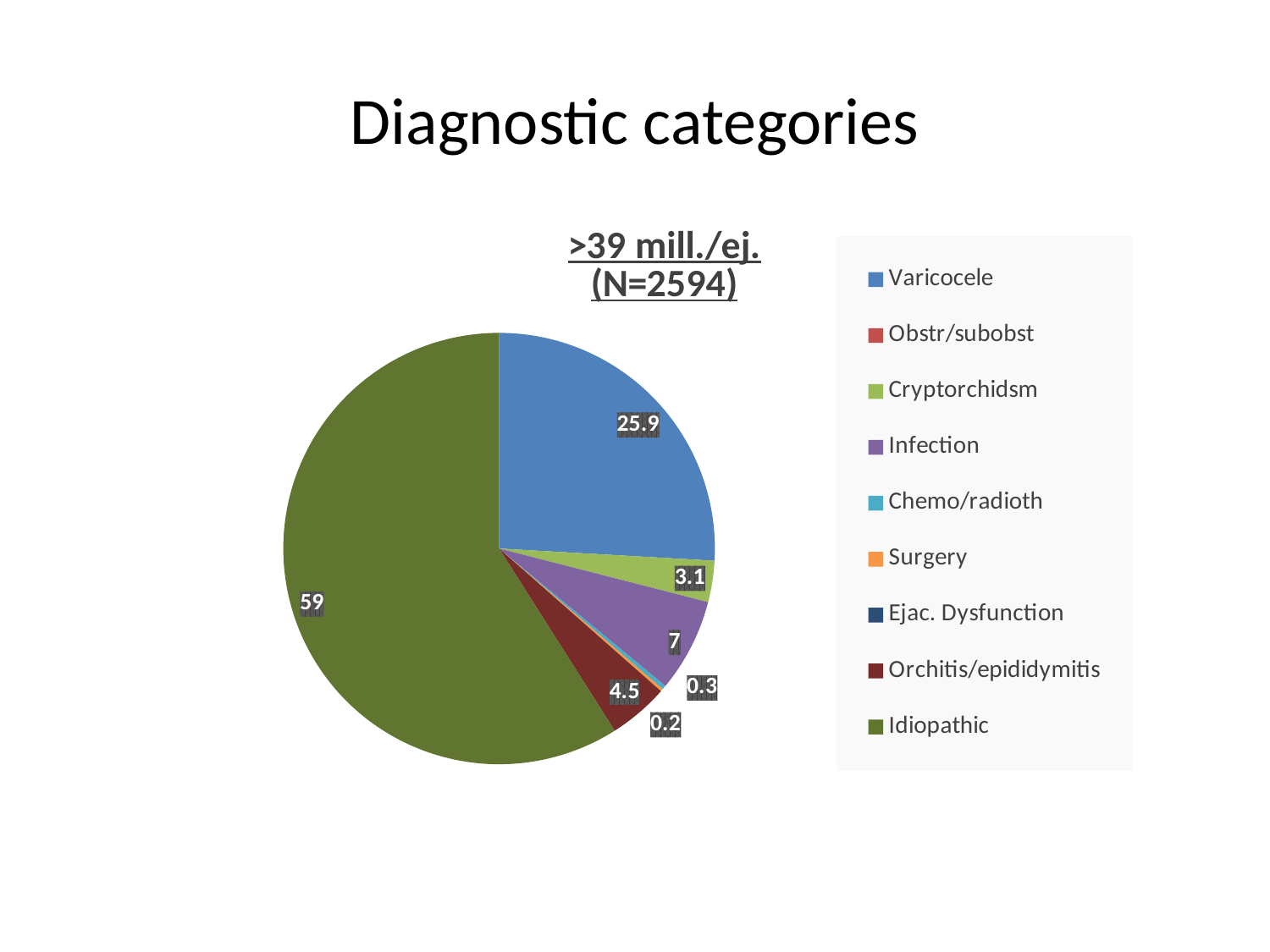
What is the value shown for Infection? 7 What is the value shown for Idiopathic? 59 What is the difference between the Idiopathic and Varicocele values? 33.1 Which diagnostic category has the largest share of the pie? Idiopathic Which is larger, the Infection slice or the Orchitis/epididymitis slice? Infection What is the value shown for Cryptorchidsm? 3.1 How many categories does the legend list? 9 What kind of chart is shown on the slide? pie chart What is the title shown above the pie chart? >39 mill./ej. (N=2594) What is the value shown for Orchitis/epididymitis? 4.5 What is the value shown for Varicocele? 25.9 What colour is the Idiopathic slice? green